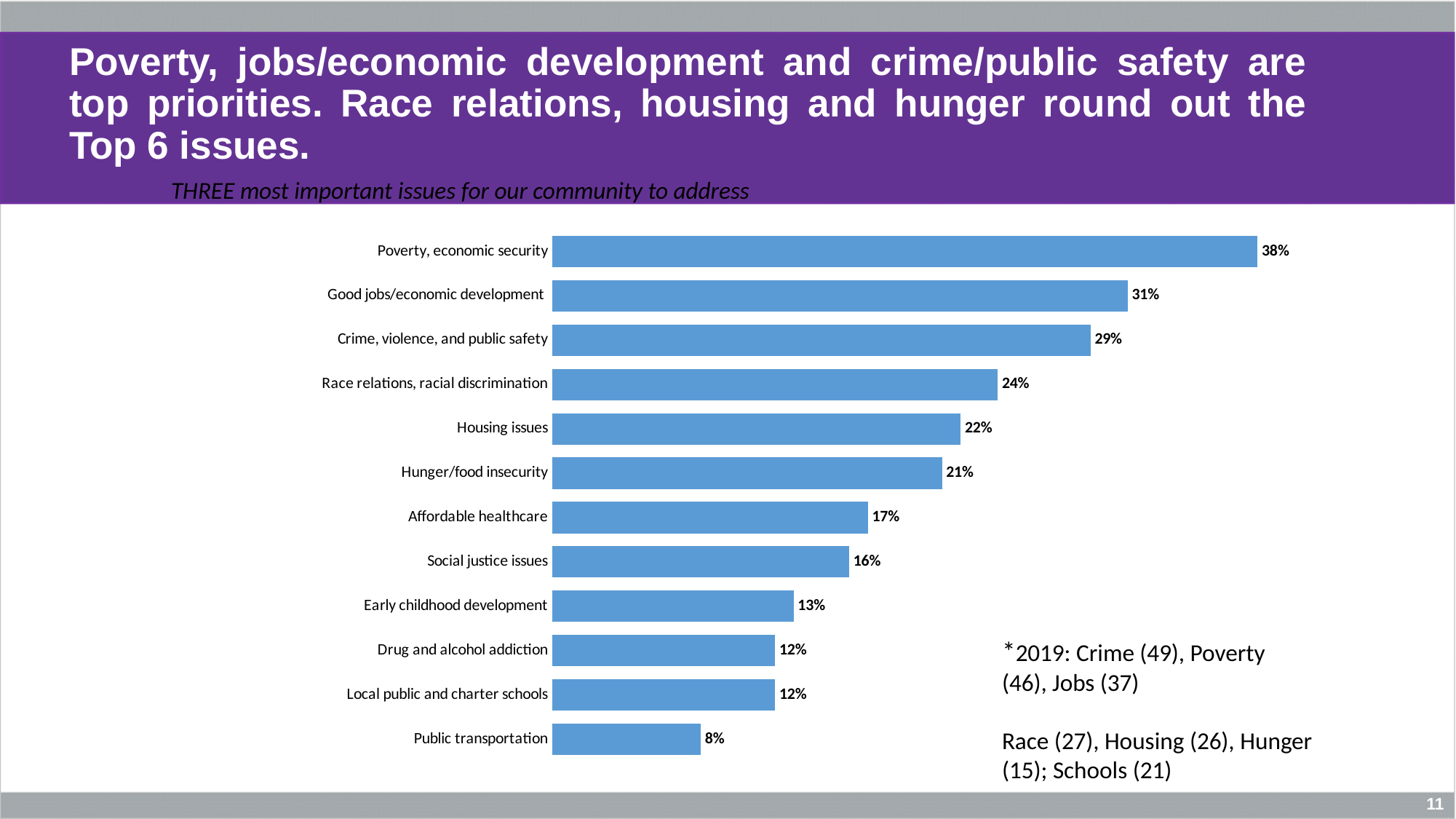
What kind of chart is shown on the slide? Bar chart What percentage of respondents chose Poverty, economic security as one of the three most important issues? 38% What is the subtitle of the chart shown above the bars? THREE most important issues for our community to address Which issue has the lowest percentage in the chart? Public transportation What is the difference between the percentages for Poverty, economic security and Public transportation? 30% What is the difference between the percentages for Good jobs/economic development and Crime, violence, and public safety? 2% What is the value shown for Housing issues? 22% How many issues are listed in the chart? 12 Which has a larger value: Social justice issues or Early childhood development? Social justice issues Which has a larger value: Race relations, racial discrimination or Hunger/food insecurity? Race relations, racial discrimination What is the value shown for Affordable healthcare? 17% Which issue has the highest percentage in the chart? Poverty, economic security